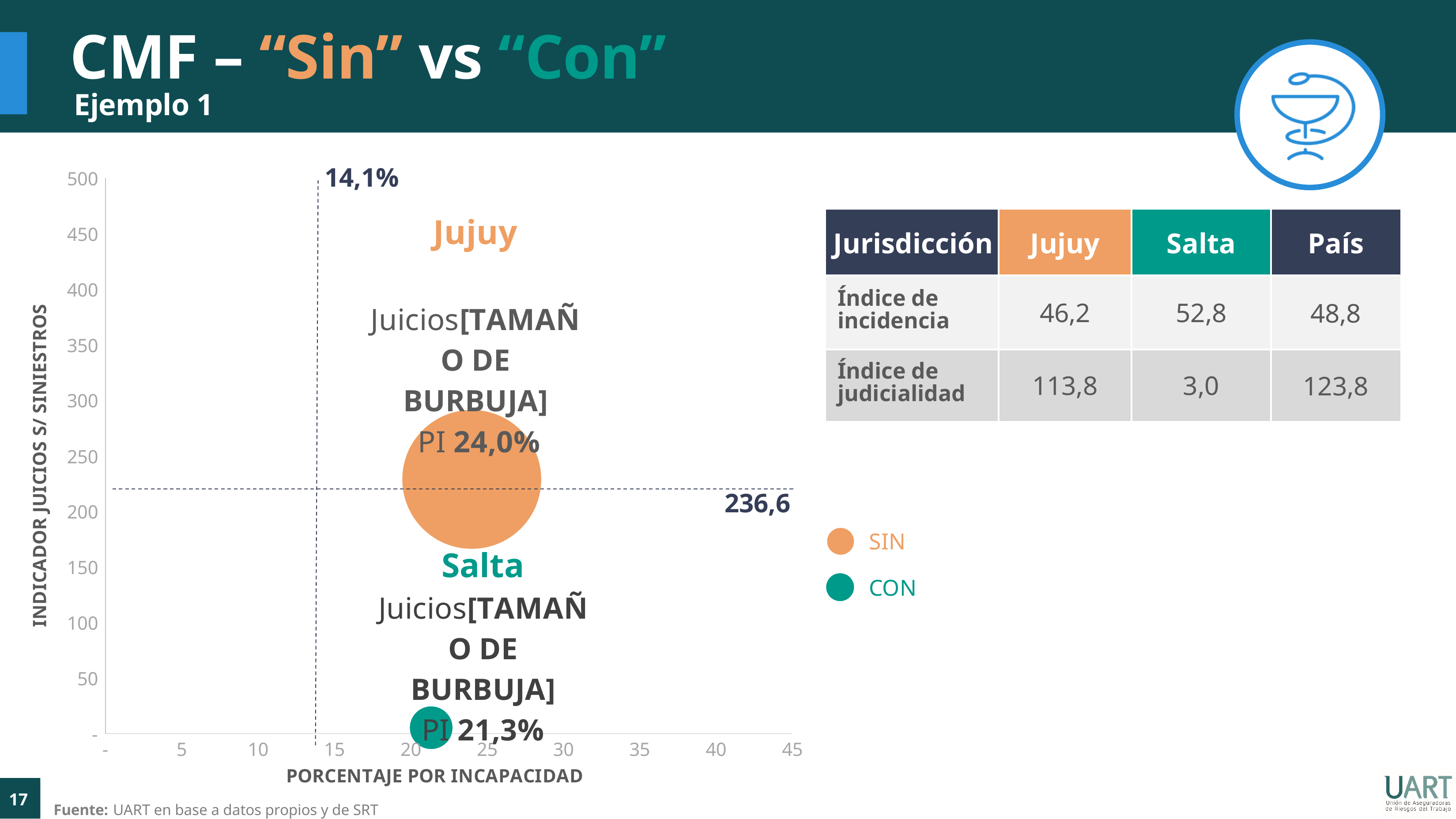
What kind of chart is shown on the slide? bubble chart What is the title of the x axis of the chart? PORCENTAJE POR INCAPACIDAD What PI value is labelled on the Jujuy bubble? 24,0% What PI value is labelled on the Salta bubble? 21,3% What value is labelled on the vertical dashed reference line? 14,1% What value is labelled on the horizontal dashed reference line? 236,6 Is the y-axis value of the Jujuy bubble greater or less than 100? greater How many bubbles are plotted on the chart? 2 What is the difference between the PI values of Jujuy and Salta? 2,7 percentage points Which bubble sits higher on the y axis (Indicador juicios s/ siniestros), Jujuy or Salta? Jujuy Is the y-axis value of the Salta bubble greater or less than 50? less How many series does the legend list? 2